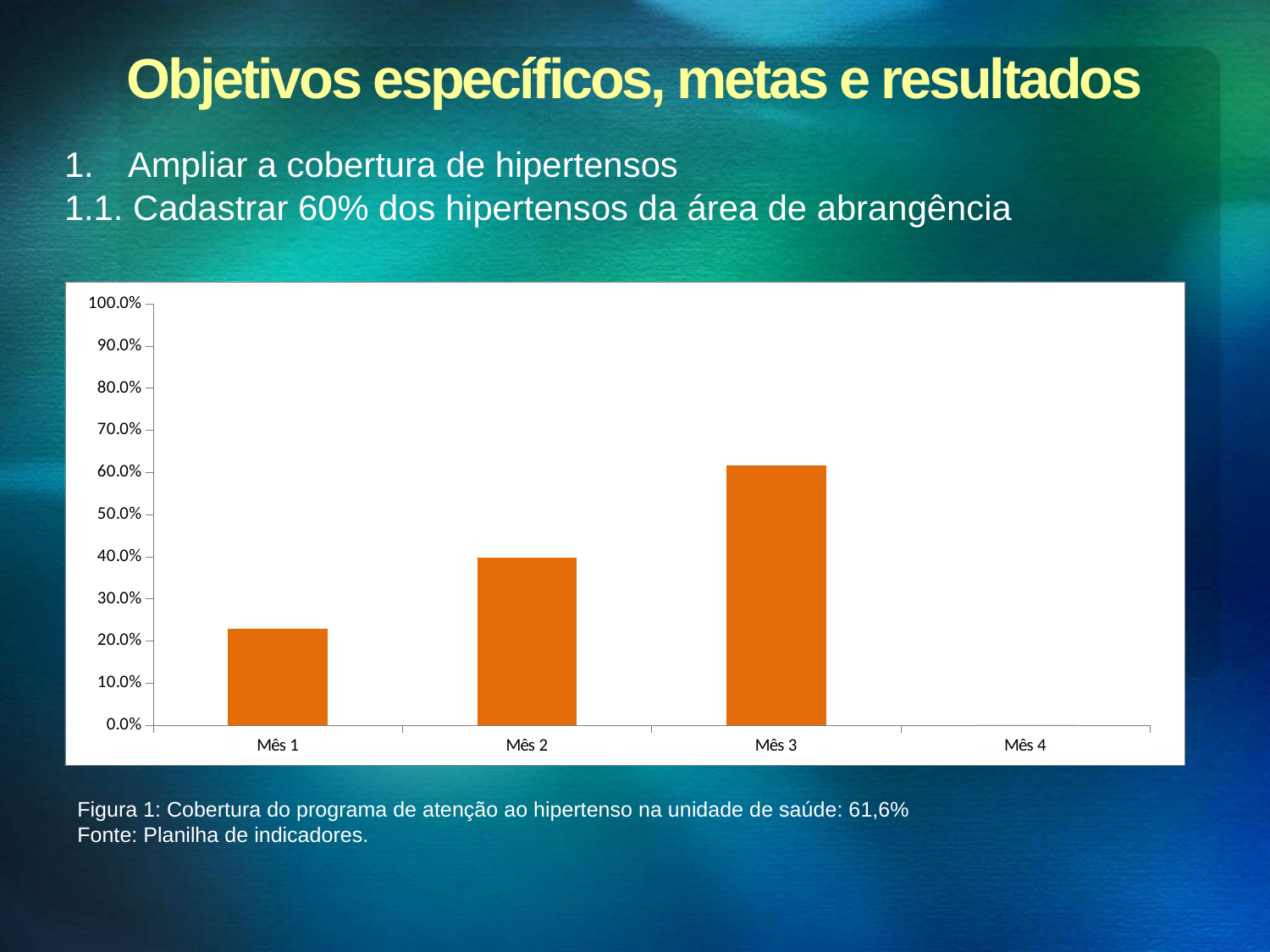
Which month has the highest bar in the chart? Mês 3 Is the value for Mês 3 greater or less than 50.0%? greater Which month has the lowest value in the chart? Mês 4 Which is larger, the value for Mês 1 or the value for Mês 2? Mês 2 What kind of chart is shown on the slide? bar chart Is the value for Mês 1 greater or less than 30.0%? less What is the highest value shown on the y axis of the chart? 100.0% What colour are the bars in the chart? orange How many categories are shown on the x axis of the chart? 4 Is the value for Mês 2 greater or less than 30.0%? greater Do the values rise or fall from Mês 1 to Mês 3? rise